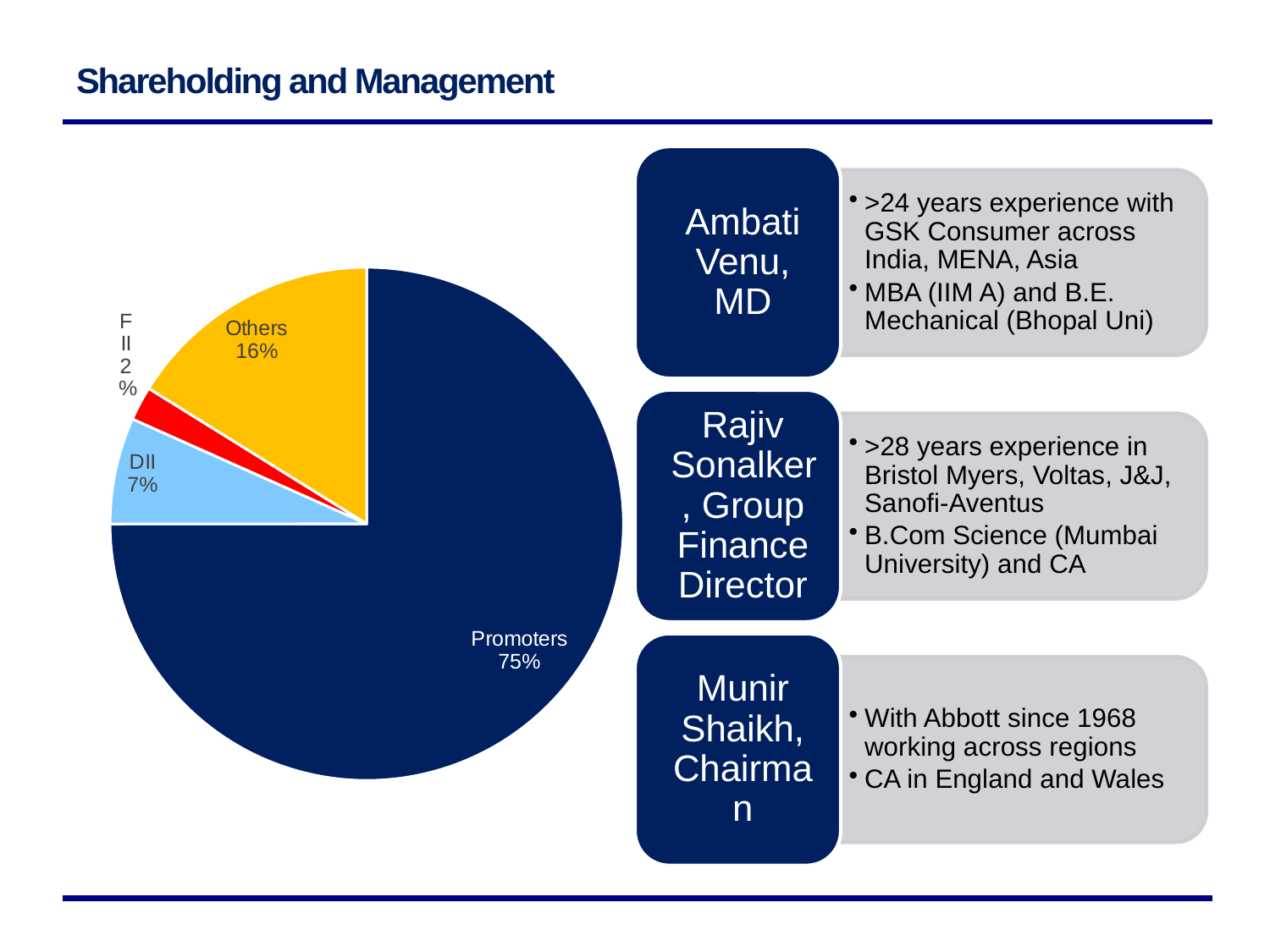
Which slice of the pie chart is the largest? Promoters Which is larger, the DII slice or the Others slice? Others What is the difference in percentage points between the Promoters slice and the Others slice? 59 What share of shareholding does the Others slice represent? 16% What share of shareholding does DII hold? 7% What share of shareholding do Promoters hold in the pie chart? 75% Which slice of the pie chart is the smallest? FII What share of shareholding does FII hold? 2% What type of chart is shown on the slide? Pie chart What is the difference in percentage points between the DII slice and the FII slice? 5 How many slices does the pie chart have? 4 What colour is the Others slice in the pie chart? Yellow